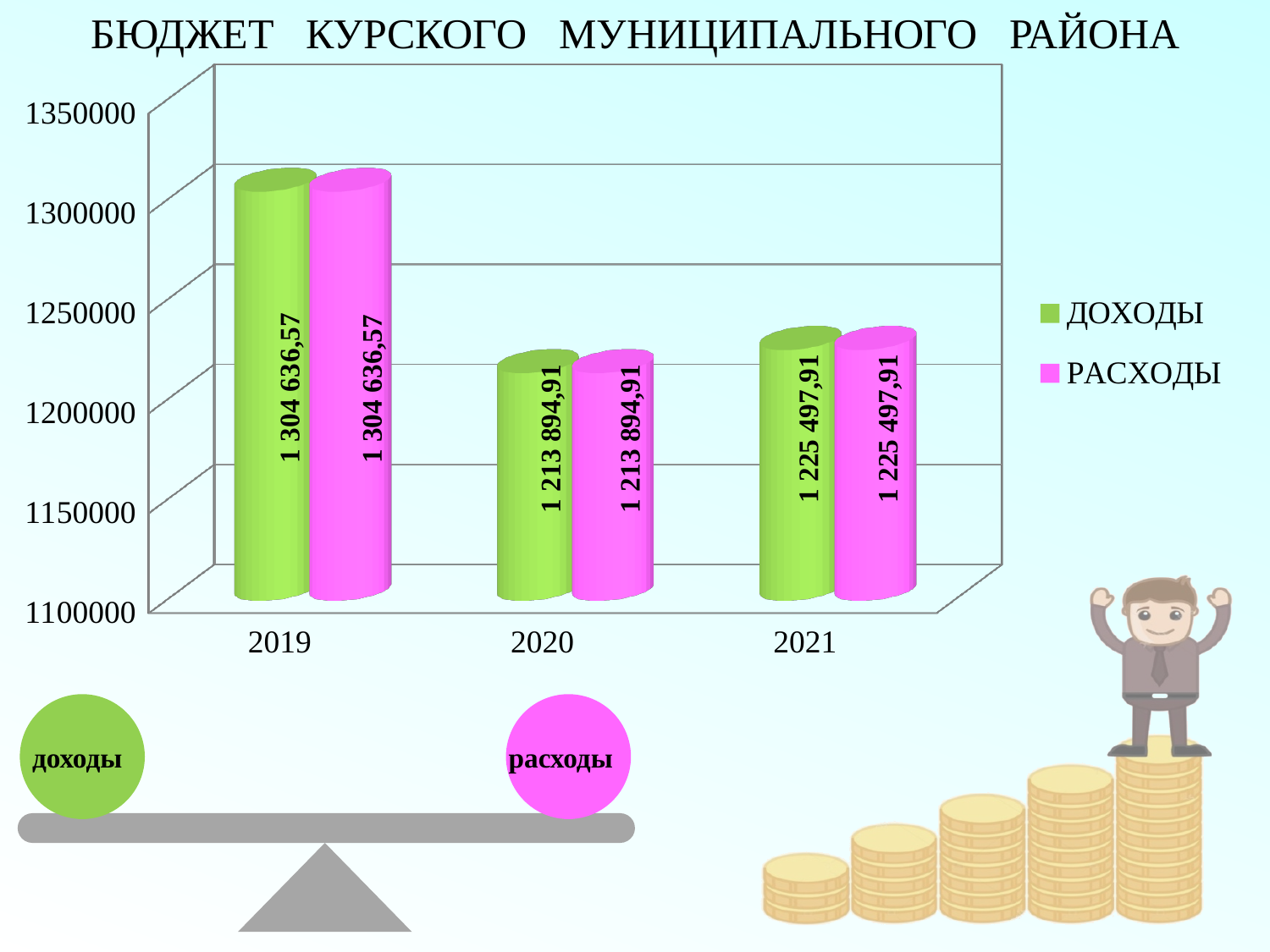
What is the difference between the ДОХОДЫ value for 2019 and the ДОХОДЫ value for 2020? 90 741,66 Which is larger: the РАСХОДЫ value for 2021 or the РАСХОДЫ value for 2020? 2021 What kind of chart is shown on the slide? bar chart Which year has the highest value for ДОХОДЫ? 2019 What is the title of the chart? БЮДЖЕТ КУРСКОГО МУНИЦИПАЛЬНОГО РАЙОНА How many series does the chart legend list? 2 What is the value of ДОХОДЫ for 2021? 1 225 497,91 What is the value of ДОХОДЫ for 2019? 1 304 636,57 What is the value of РАСХОДЫ for 2020? 1 213 894,91 How many years are shown on the x axis of the chart? 3 Which year has the lowest value for РАСХОДЫ? 2020 Is the value of ДОХОДЫ for 2019 greater or less than 1300000? greater